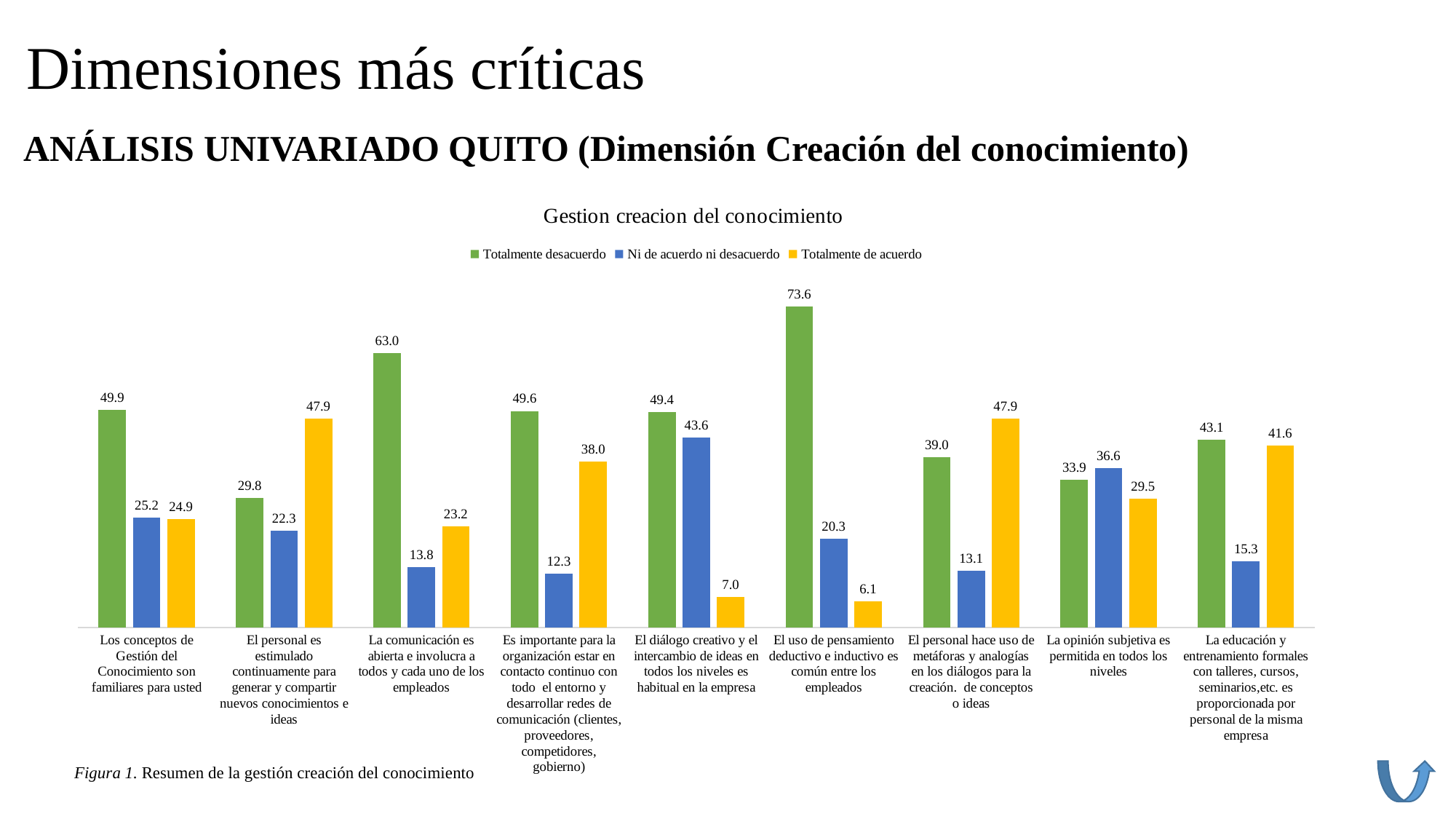
How many categories are shown along the x axis of the chart? 9 For 'La opinión subjetiva es permitida en todos los niveles', which is larger: the 'Totalmente desacuerdo' value or the 'Ni de acuerdo ni desacuerdo' value? Ni de acuerdo ni desacuerdo How many series does the legend of the chart list? 3 What type of chart is shown on the slide? bar chart What is the 'Ni de acuerdo ni desacuerdo' value for 'El diálogo creativo y el intercambio de ideas en todos los niveles es habitual en la empresa'? 43.6 Which category has the lowest 'Totalmente de acuerdo' value? El uso de pensamiento deductivo e inductivo es común entre los empleados What is the 'Totalmente desacuerdo' value for 'El uso de pensamiento deductivo e inductivo es común entre los empleados'? 73.6 What is the 'Totalmente de acuerdo' value for 'La comunicación es abierta e involucra a todos y cada uno de los empleados'? 23.2 Which category has the highest 'Totalmente desacuerdo' value? El uso de pensamiento deductivo e inductivo es común entre los empleados What is the difference between the 'Totalmente desacuerdo' and 'Totalmente de acuerdo' values for 'La comunicación es abierta e involucra a todos y cada uno de los empleados'? 39.8 What is the title of the chart? Gestion creacion del conocimiento What is the 'Totalmente de acuerdo' value for 'El personal hace uso de metáforas y analogías en los diálogos para la creación de conceptos o ideas'? 47.9